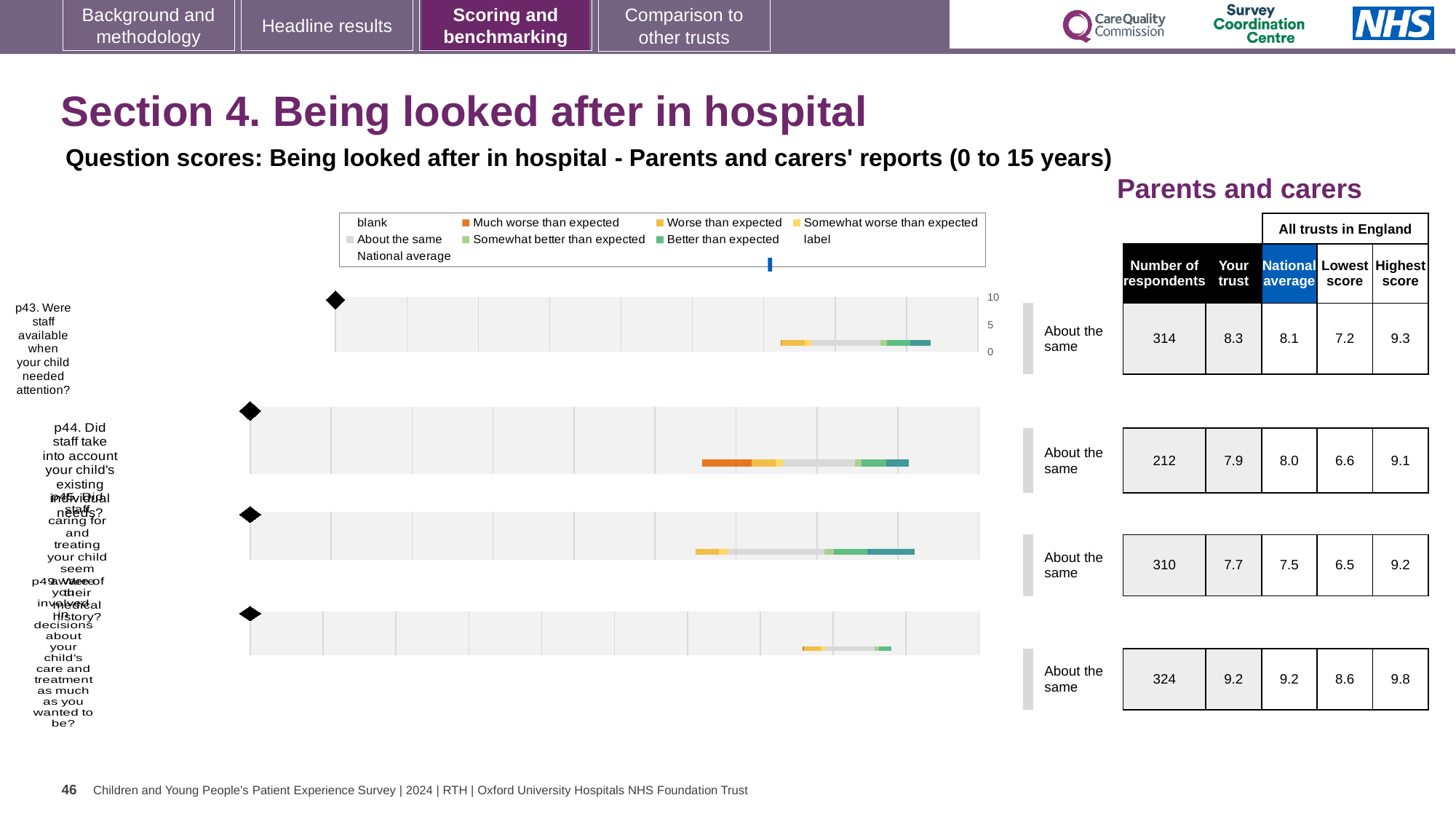
What benchmark category is shown for every question on this slide? About the same What is the highest 'Your trust' score shown in the table on this slide? 9.2 What is the highest score across all trusts in England for question p44 (Did staff take into account your child's existing individual needs?)? 9.1 What kind of chart is used to show the question scores on this slide? Bar chart What is the national average score for question p43? 8.1 What is the 'Your trust' score for question p43? 8.3 What is the lowest value in the 'Lowest score' column of the table? 6.5 What is the difference between the 'Your trust' score and the national average for question p43? 0.2 For question p44, which is larger: the 'Your trust' score or the national average? National average How many respondents are shown for question p43 (Were staff available when your child needed attention?)? 314 How many question rows (charts) are shown on this slide? 4 What is the lowest score across all trusts in England for question p44? 6.6